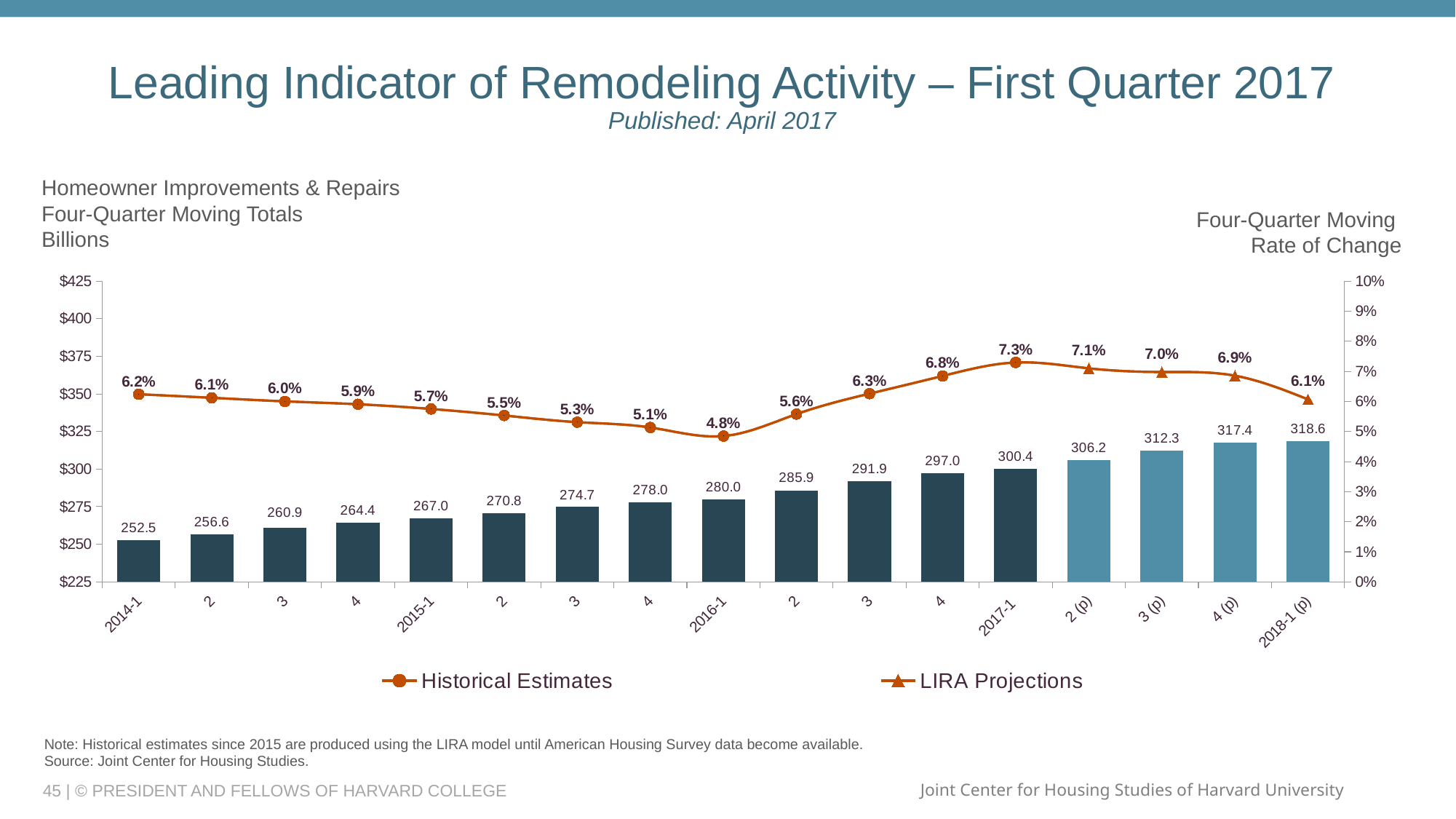
Which quarter has the highest four-quarter moving rate of change? 2017-1 What is the difference in billions between the four-quarter moving totals for 2018-1 (p) and 2017-1? 18.2 What are the two series named in the legend? Historical Estimates and LIRA Projections What is the four-quarter moving total (in billions) projected for 2018-1 (p)? 318.6 How many quarters (bars) are plotted on the chart? 17 Which quarter has the lowest four-quarter moving rate of change? 2016-1 Which is larger, the rate of change for 2014-1 or the rate of change for 2018-1 (p)? 2014-1 How many series does the legend list? 2 Do the four-quarter moving totals (bars) rise or fall from 2014-1 to 2018-1 (p)? rise What is the four-quarter moving rate of change shown for 2016-1? 4.8% Which quarter has the lowest four-quarter moving total in billions? 2014-1 What is the four-quarter moving total (in billions) for 2017-1? 300.4